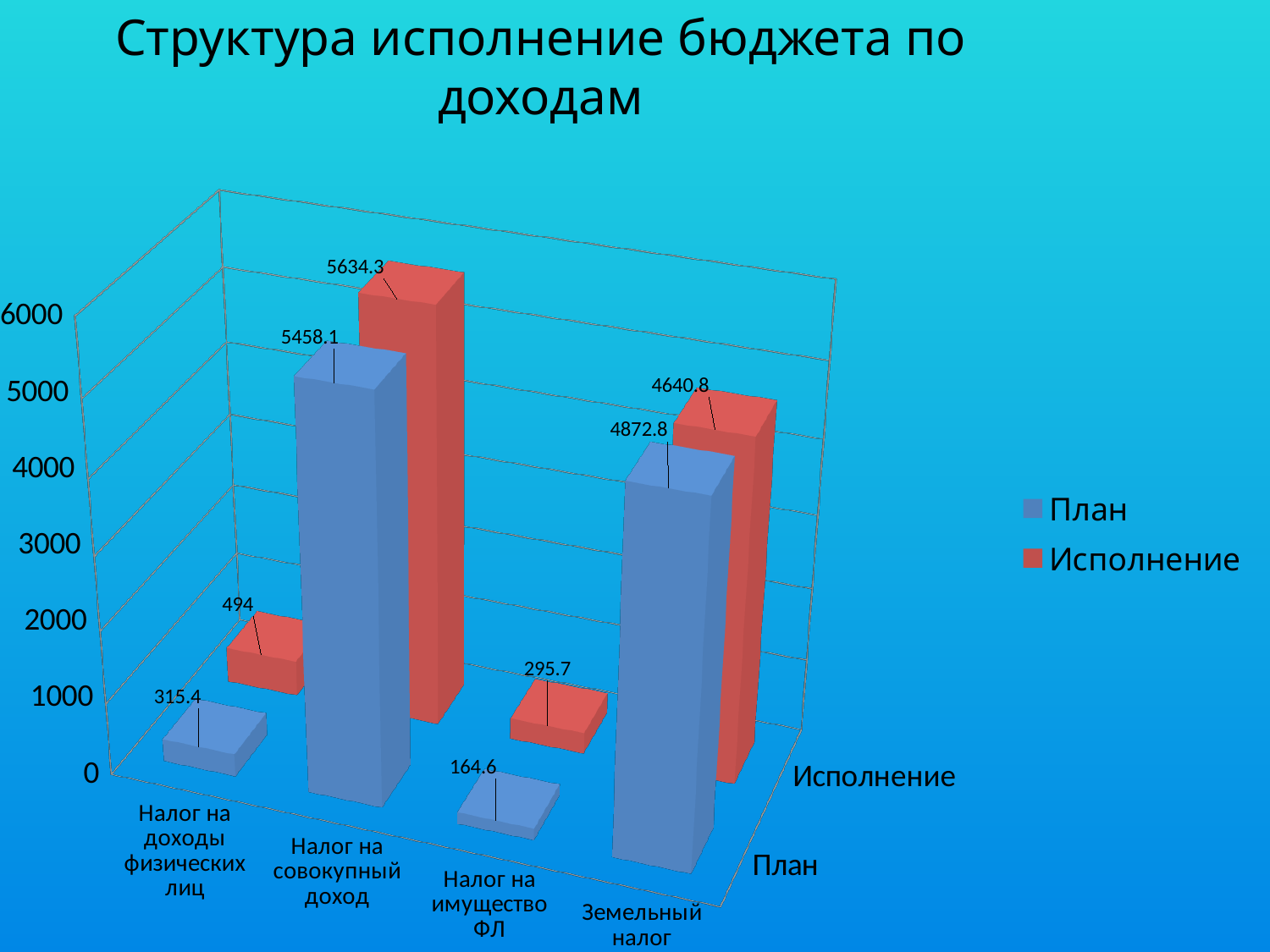
What is the План value for Налог на имущество ФЛ? 164.6 How many categories are shown on the x axis? 4 How many series does the legend list? 2 What is the План value for Налог на совокупный доход? 5458.1 What is the Исполнение value for Налог на доходы физических лиц? 494 What is the Исполнение value for Земельный налог? 4640.8 What is the title of the chart? Структура исполнение бюджета по доходам For Земельный налог, which is larger: План or Исполнение? План What kind of chart is shown on the slide? Bar chart Which category has the highest Исполнение value? Налог на совокупный доход What is the difference between the Исполнение and План values for Налог на совокупный доход? 176.2 Which category has the lowest План value? Налог на имущество ФЛ